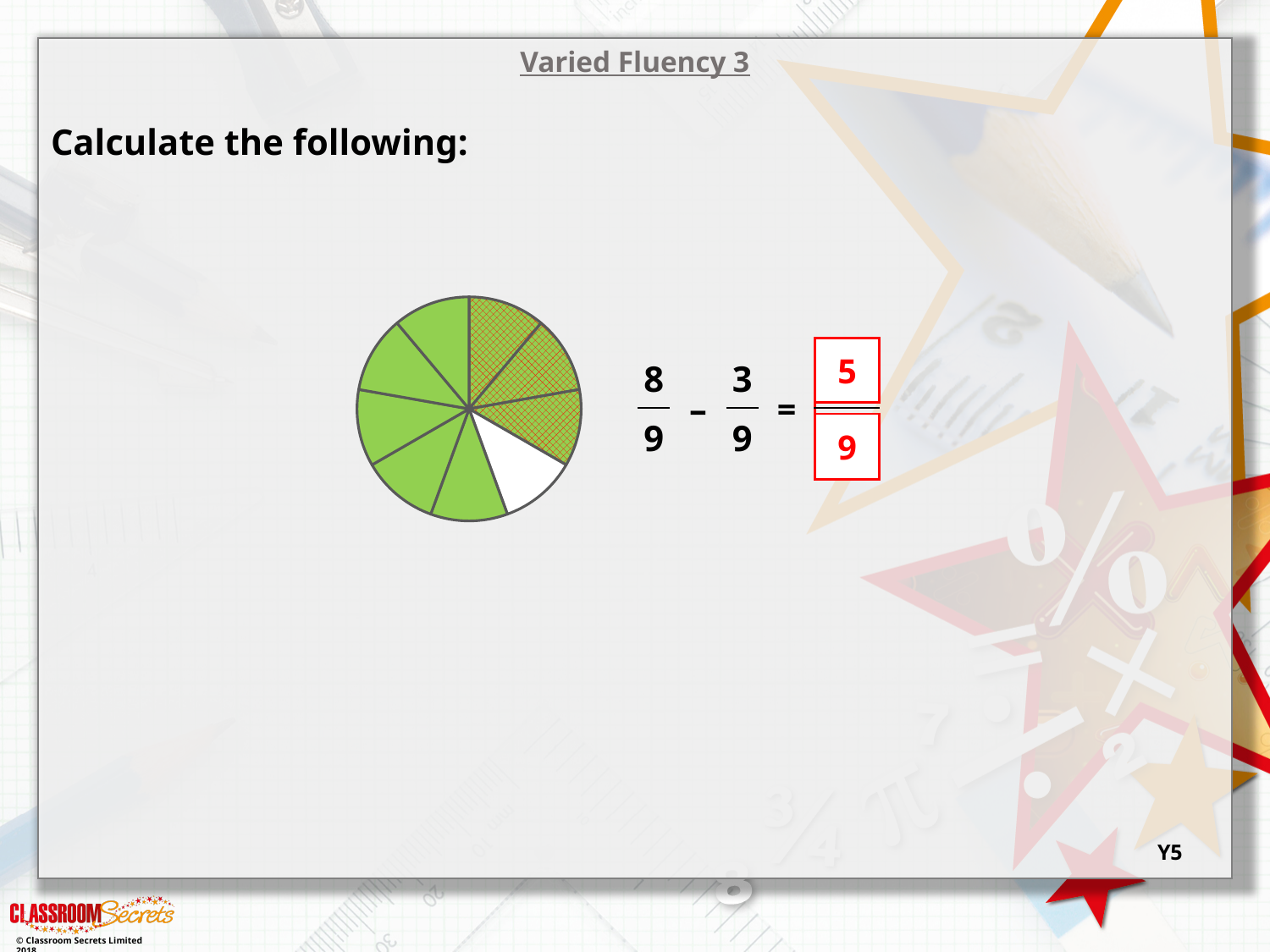
Are there more plain green slices or crosshatched slices in the pie chart? plain green How many equal slices is the pie chart divided into? 9 How many slices of the pie chart are shaded with orange crosshatching? 3 What kind of chart is shown on the slide? pie chart What fraction of the pie chart is the white slice? 1/9 How many slices of the pie chart are left white? 1 What fraction of the pie chart do the crosshatched slices represent? 3/9 What colour are the unhatched shaded slices of the pie chart? green What is the title at the top of the slide? Varied Fluency 3 What is the answer shown in the red boxes for 8/9 − 3/9? 5/9 What fraction of the pie chart do the plain green slices represent? 5/9